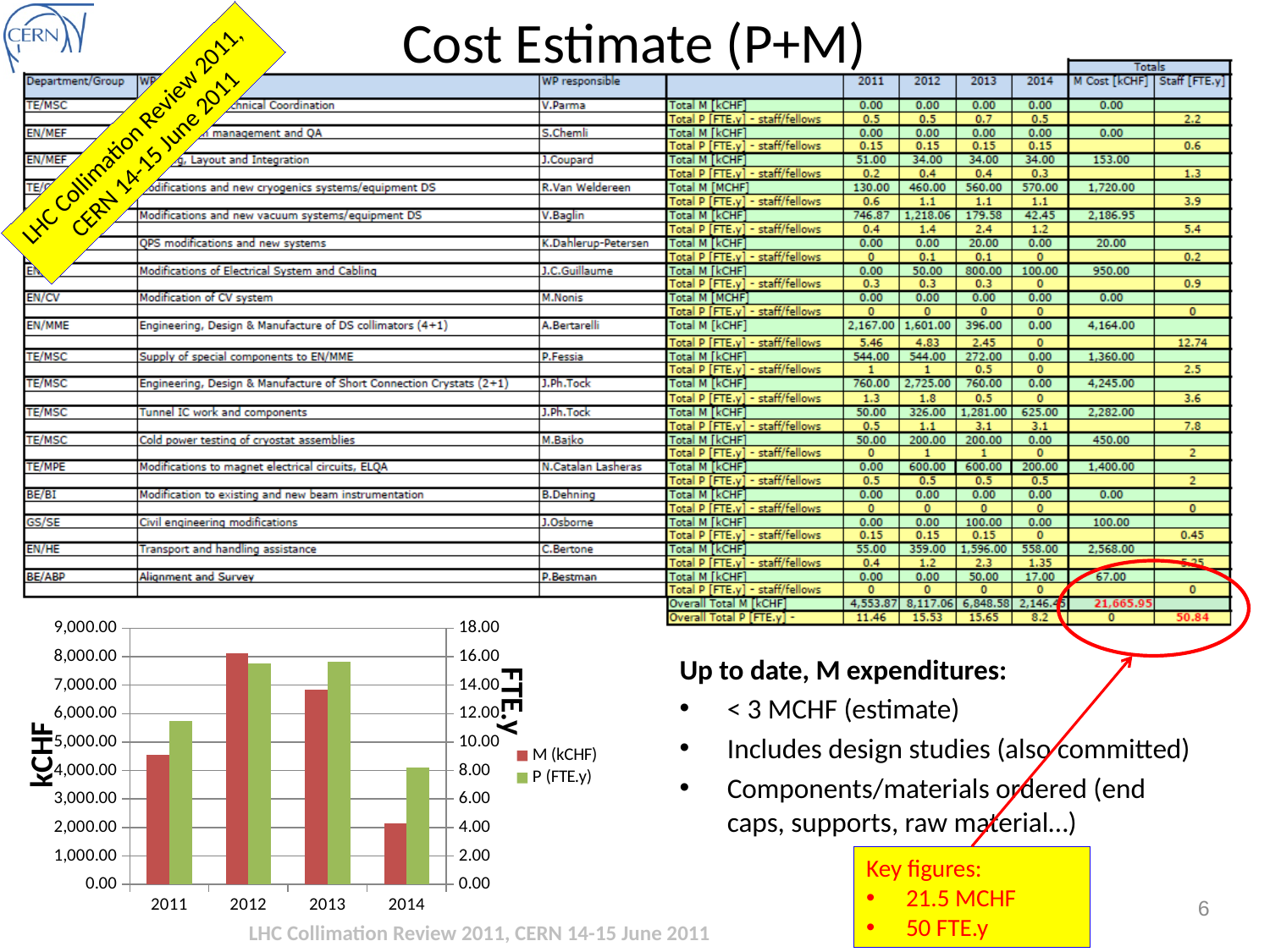
What is the label on the left vertical axis of the bar chart? kCHF In the bar chart, is the P (FTE.y) value for 2013 greater or less than 14.00? greater In the bar chart, which year has the lowest P (FTE.y) value? 2014 How many years are shown on the x axis of the bar chart? 4 In the bar chart, which year has the highest M (kCHF) value? 2012 In the bar chart, is the M (kCHF) value for 2014 greater or less than 3,000.00? less In the bar chart, which is larger: the M (kCHF) value for 2011 or for 2013? 2013 How many series does the legend of the bar chart list? 2 In the bar chart, which year has the lowest M (kCHF) value? 2014 In the bar chart, is the M (kCHF) value for 2012 greater or less than 8,000.00? greater In the bar chart, does the M (kCHF) value rise or fall from 2012 to 2014? fall What kind of chart is shown at the bottom left of the slide? bar chart